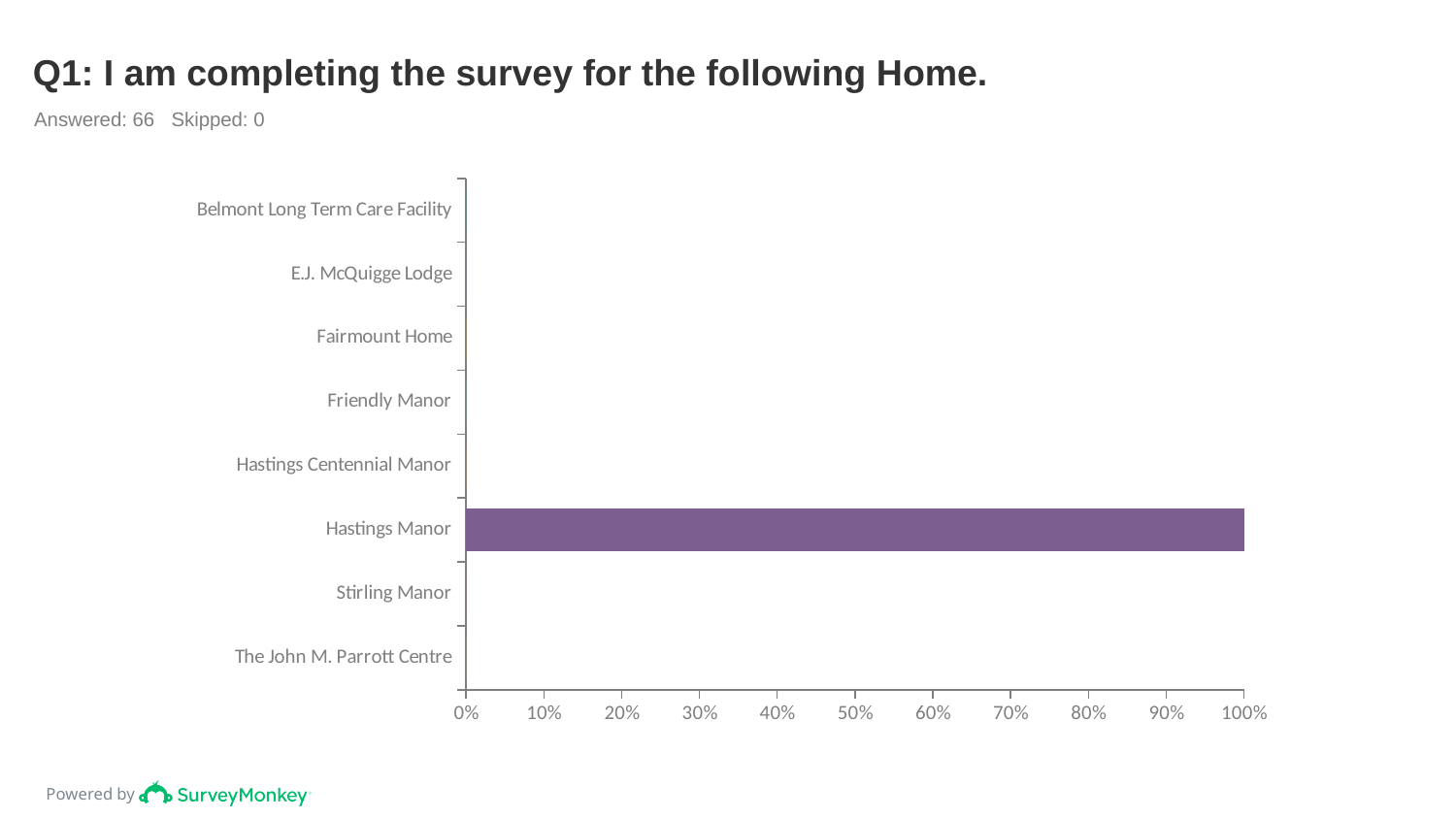
Is the value for Hastings Manor greater or less than 50%? greater What is the highest value shown on the x axis? 100% How many homes are listed as categories on the chart? 8 Is the value for Stirling Manor greater or less than 10%? less How many respondents answered the question according to the slide? 66 Which home has the highest value on the chart? Hastings Manor Is the value for The John M. Parrott Centre greater or less than 20%? less Which is larger, the value for Fairmount Home or the value for Hastings Manor? Hastings Manor What is the value for Hastings Manor? 100% Which is larger, the value for Hastings Manor or the value for Friendly Manor? Hastings Manor What is the title of the chart? Q1: I am completing the survey for the following Home. What kind of chart is shown on the slide? bar chart